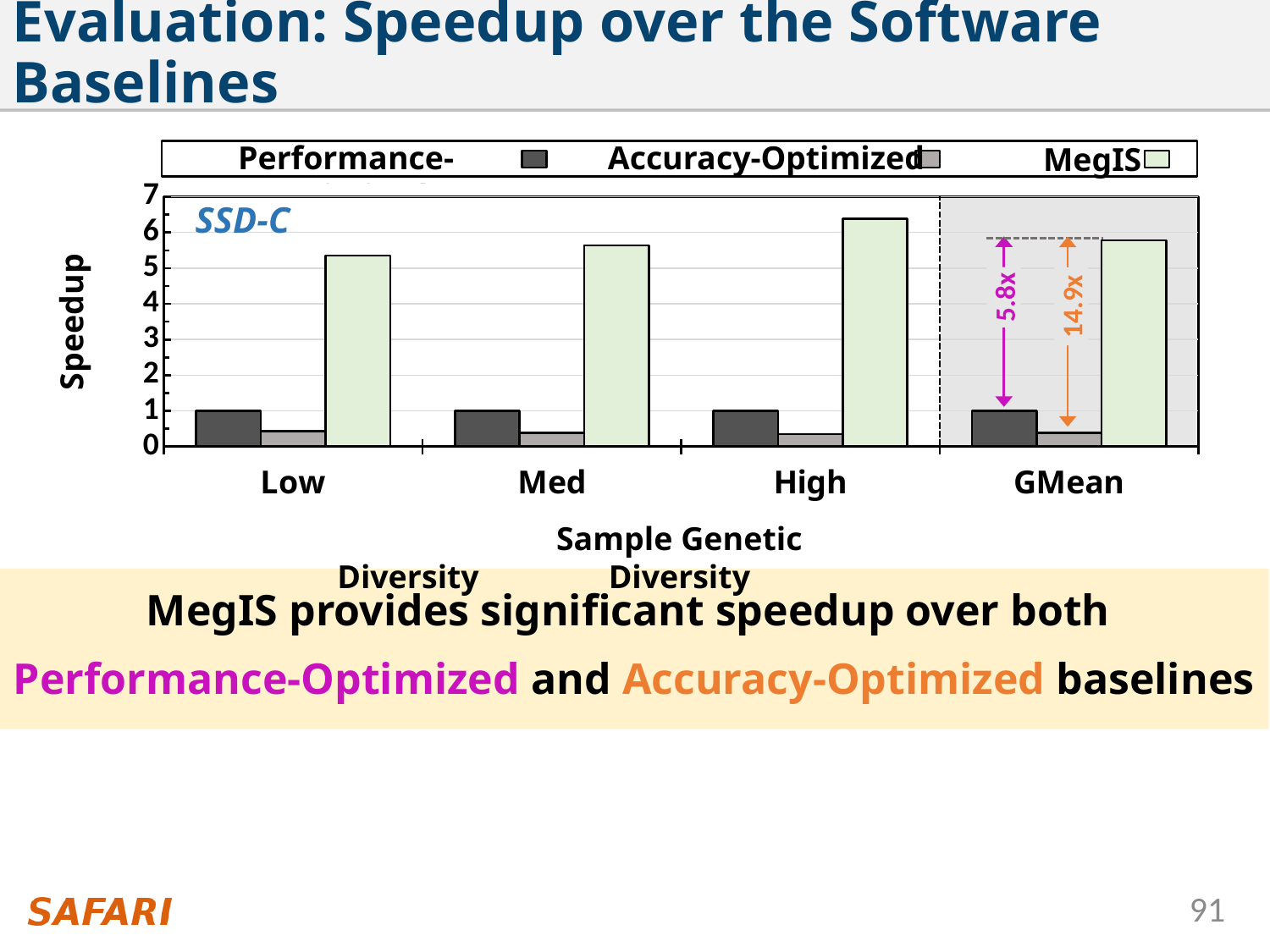
Do the MegIS bars rise or fall from Low to High? rise What is the label on the y axis of the chart? Speedup What kind of chart is shown on the slide? bar chart Is the MegIS value for Low greater or less than 5? greater According to the annotation in the GMean group, what is the speedup of MegIS over the Accuracy-Optimized baseline? 14.9x How many series does the chart's legend list? 3 Which category has the highest MegIS bar? High How many categories are shown on the x axis of the chart? 4 For the Low category, which is larger: the MegIS bar or the Performance-Optimized bar? MegIS Is the Accuracy-Optimized value for Med greater or less than 1? less According to the annotation in the GMean group, what is the speedup of MegIS over the Performance-Optimized baseline? 5.8x Is the MegIS value for High greater or less than 6? greater